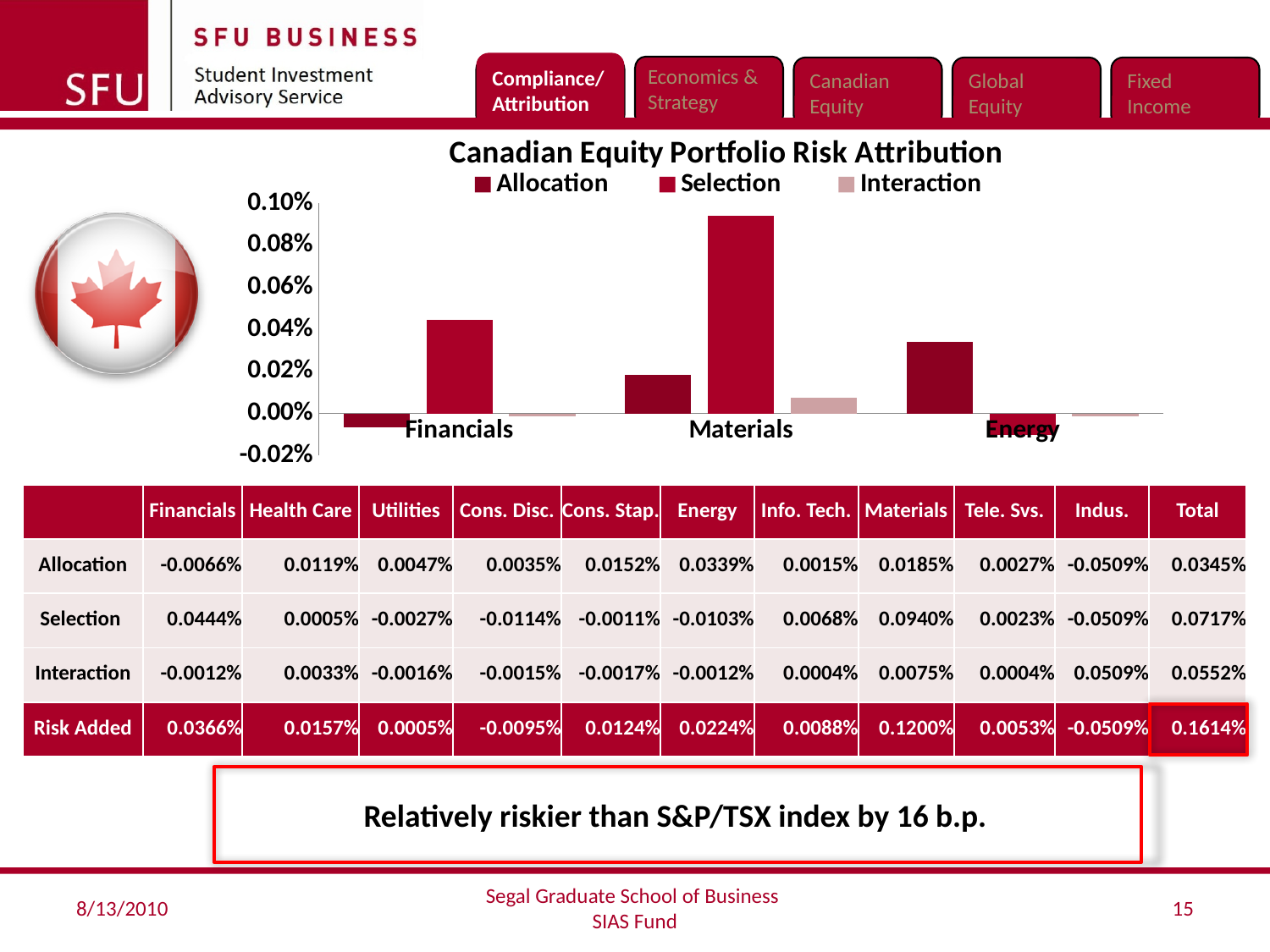
How many series does the chart legend list? 3 Is the Allocation value for Energy greater or less than 0.02%? greater Is the Selection value for Materials greater or less than 0.08%? greater Which category has the lowest Allocation bar in the chart? Financials Which is larger in the chart, the Allocation bar for Materials or the Allocation bar for Energy? Energy What is the title of the chart? Canadian Equity Portfolio Risk Attribution Is the Selection value for Financials greater or less than 0.06%? less Which series in the chart is drawn in the lightest pink colour? Interaction Which is larger in the chart, the Selection bar for Financials or the Selection bar for Energy? Financials What kind of chart is shown on the slide? bar chart How many categories are shown on the x axis of the chart? 3 Which category has the tallest Selection bar in the chart? Materials